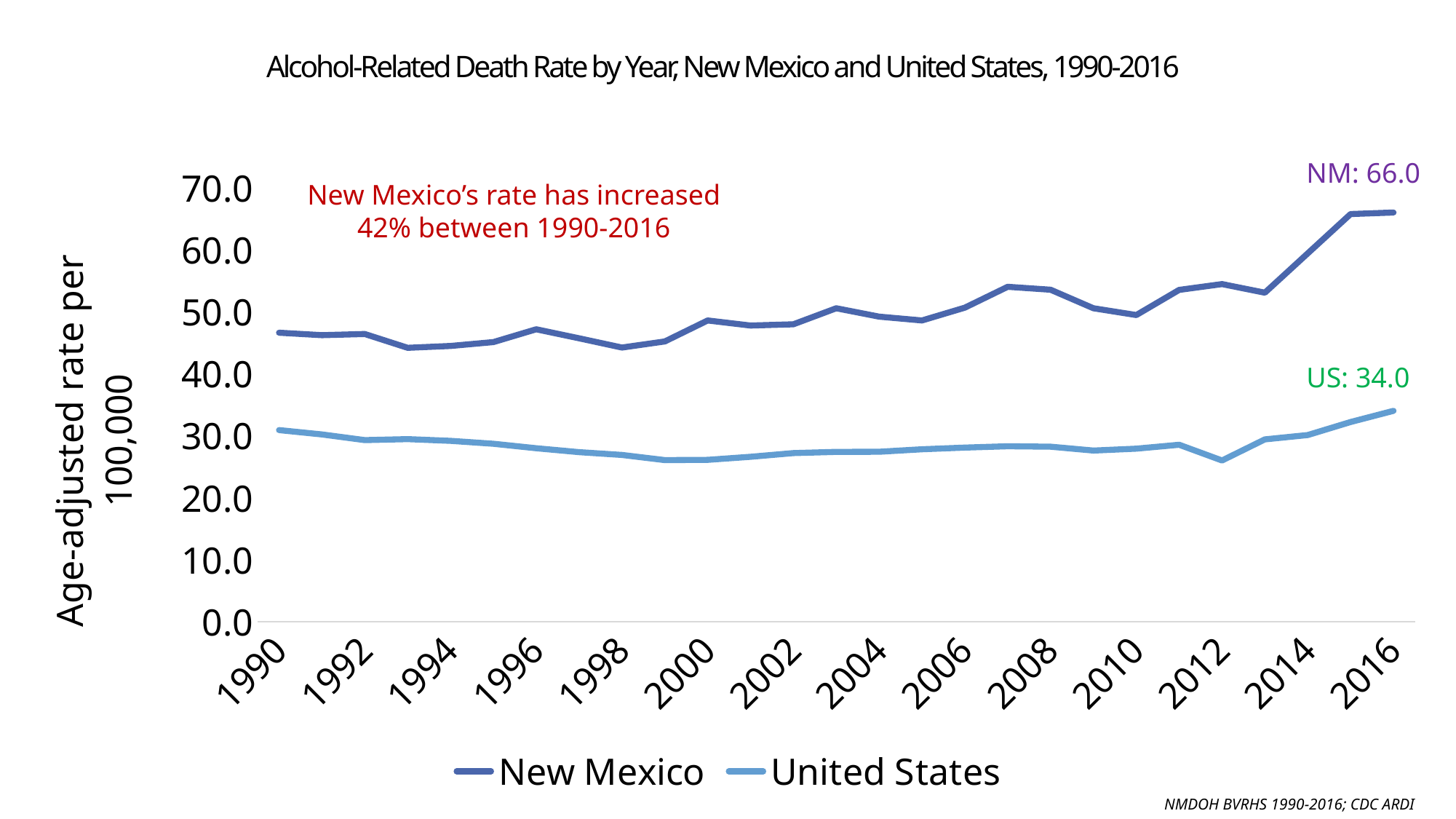
Is the New Mexico rate in 2008 greater or less than 50.0? greater Which series has the higher rate in 2016, New Mexico or United States? New Mexico Is the United States rate in 2000 greater or less than 30.0? less How many series does the legend list? 2 Does the New Mexico rate rise or fall overall from 1990 to 2016? Rise What is the New Mexico alcohol-related death rate in 2016? 66.0 By what percentage does the slide say New Mexico's rate increased between 1990 and 2016? 42% What is the difference between the New Mexico and United States rates in 2016? 32.0 What is the title of the chart? Alcohol-Related Death Rate by Year, New Mexico and United States, 1990-2016 What is the United States alcohol-related death rate in 2016? 34.0 Is the New Mexico rate in 1990 greater or less than 40.0? greater What kind of chart is shown on the slide? Line chart